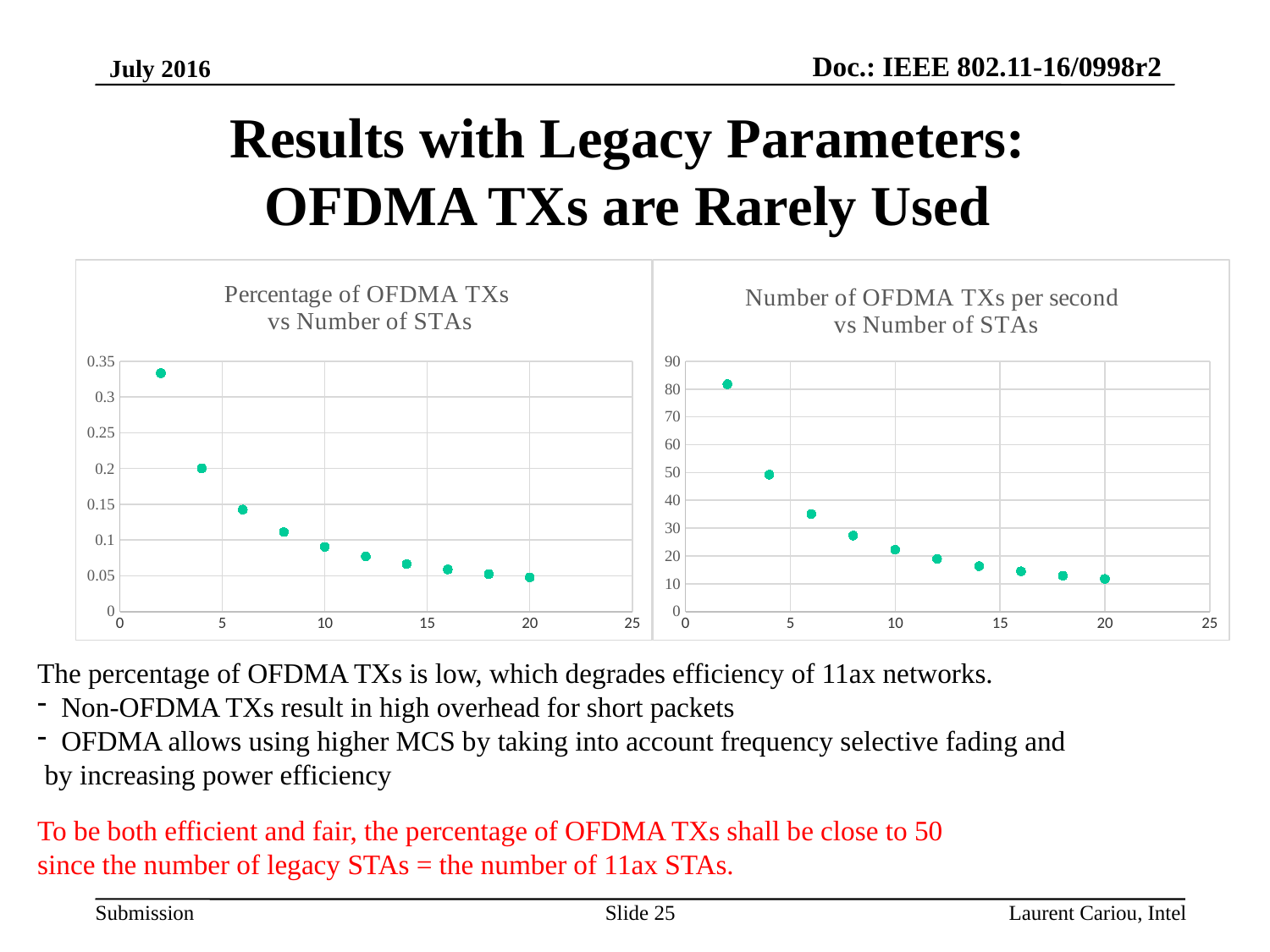
In the left chart, 'Percentage of OFDMA TXs vs Number of STAs', do the values rise or fall as the number of STAs increases? fall In the right chart, 'Number of OFDMA TXs per second vs Number of STAs', do the values rise or fall as the number of STAs increases? fall What kind of chart is the left chart, 'Percentage of OFDMA TXs vs Number of STAs'? scatter chart How many data points are plotted in the left chart, 'Percentage of OFDMA TXs vs Number of STAs'? 10 In the right chart, 'Number of OFDMA TXs per second vs Number of STAs', is the value at 10 STAs greater or less than 30? less How many data points are plotted in the right chart, 'Number of OFDMA TXs per second vs Number of STAs'? 10 In the left chart, 'Percentage of OFDMA TXs vs Number of STAs', is the value at 2 STAs greater or less than 0.3? greater In the left chart, 'Percentage of OFDMA TXs vs Number of STAs', which is larger: the value at 4 STAs or the value at 8 STAs? 4 STAs In the right chart, 'Number of OFDMA TXs per second vs Number of STAs', is the value at 2 STAs greater or less than 80? greater In the right chart, 'Number of OFDMA TXs per second vs Number of STAs', at which number of STAs is the value highest? 2 What kind of chart is the right chart, 'Number of OFDMA TXs per second vs Number of STAs'? scatter chart